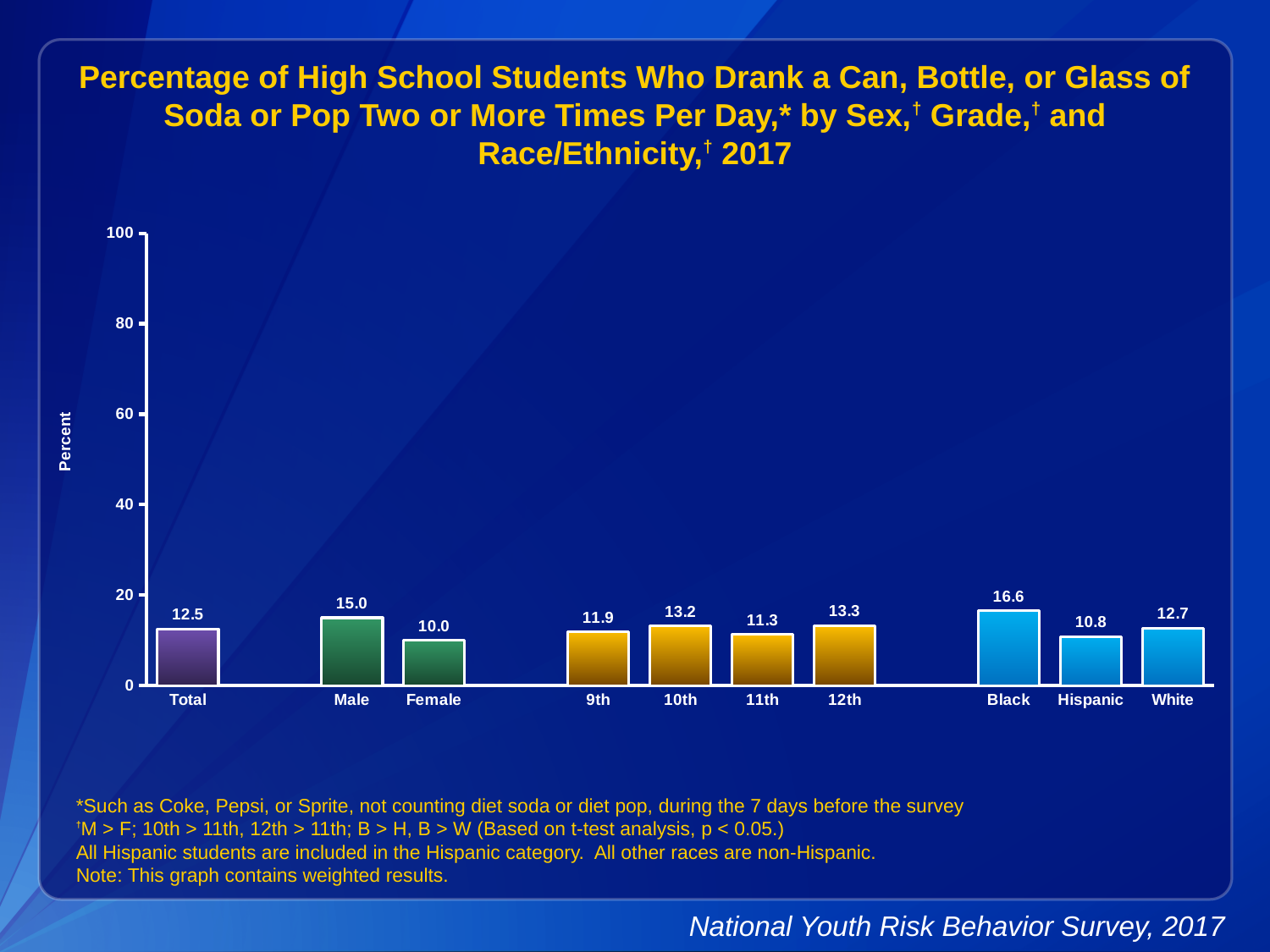
What is the value for Total? 12.5 Which category has the lowest value? Female Which category has the highest value? Black What is the value for Hispanic? 10.8 What is the value for Male? 15.0 Is the value for Black greater or less than 20? less What is the label of the y axis? Percent How many categories are shown on the x axis? 10 What is the difference between the values for Black and White? 3.9 Which is larger, the value for 10th or the value for 11th? 10th What is the difference between the values for Male and Female? 5.0 What kind of chart is this? bar chart